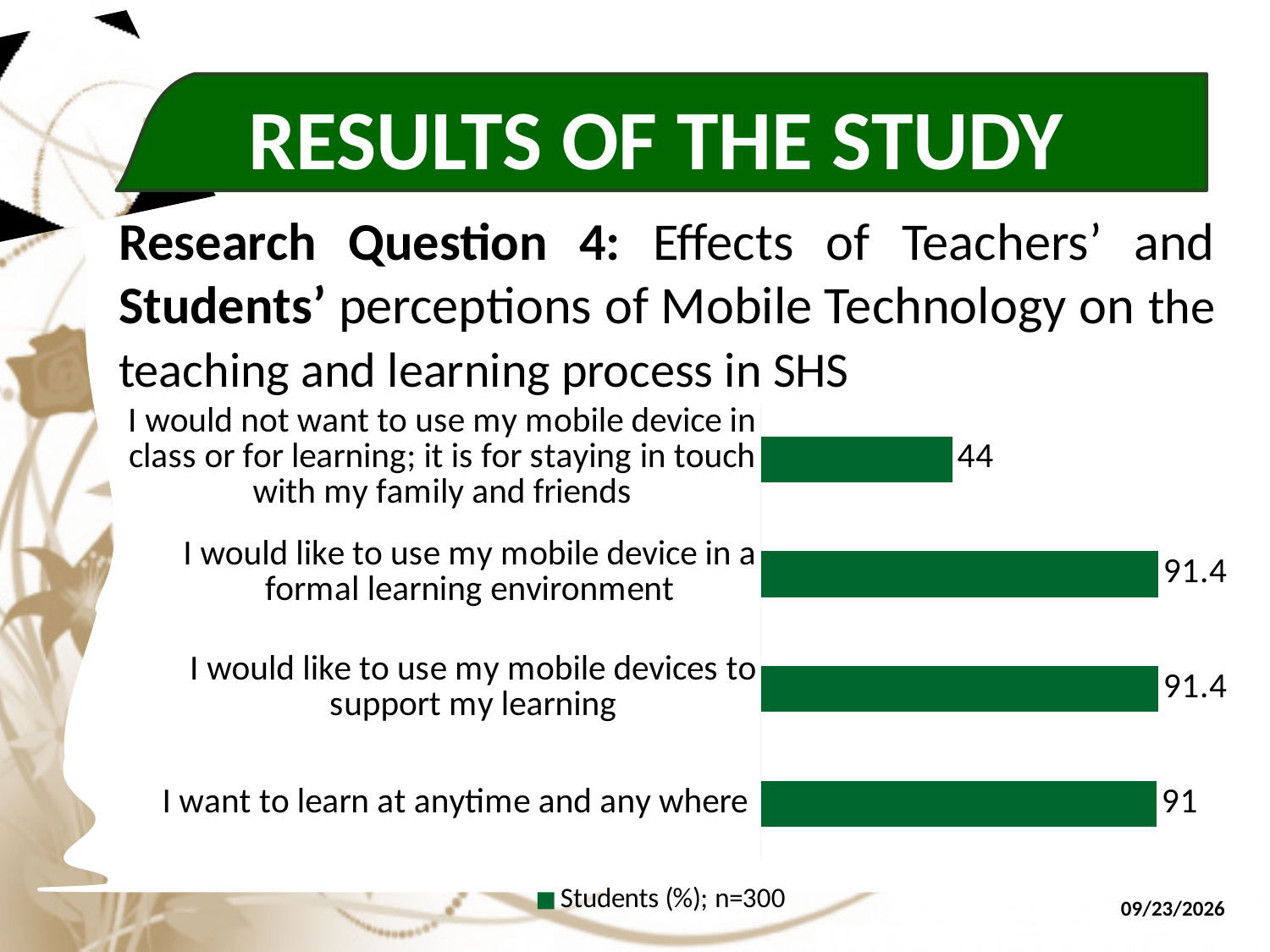
What is the value for "I would not want to use my mobile device in class or for learning; it is for staying in touch with my family and friends"? 44 What kind of chart is shown on the slide? Bar chart What is the value for "I want to learn at anytime and any where"? 91 How many series does the legend list? 1 What is the difference between the value for "I would like to use my mobile device in a formal learning environment" and the value for "I would not want to use my mobile device in class or for learning; it is for staying in touch with my family and friends"? 47.4 How many categories are shown in the chart? 4 Which category has the lowest value? I would not want to use my mobile device in class or for learning; it is for staying in touch with my family and friends What is the value for "I would like to use my mobile devices to support my learning"? 91.4 What is the difference between the value for "I would like to use my mobile devices to support my learning" and the value for "I want to learn at anytime and any where"? 0.4 What is the legend entry for the series in the chart? Students (%); n=300 Which is larger: the value for "I want to learn at anytime and any where" or the value for "I would not want to use my mobile device in class or for learning; it is for staying in touch with my family and friends"? I want to learn at anytime and any where What is the value for "I would like to use my mobile device in a formal learning environment"? 91.4